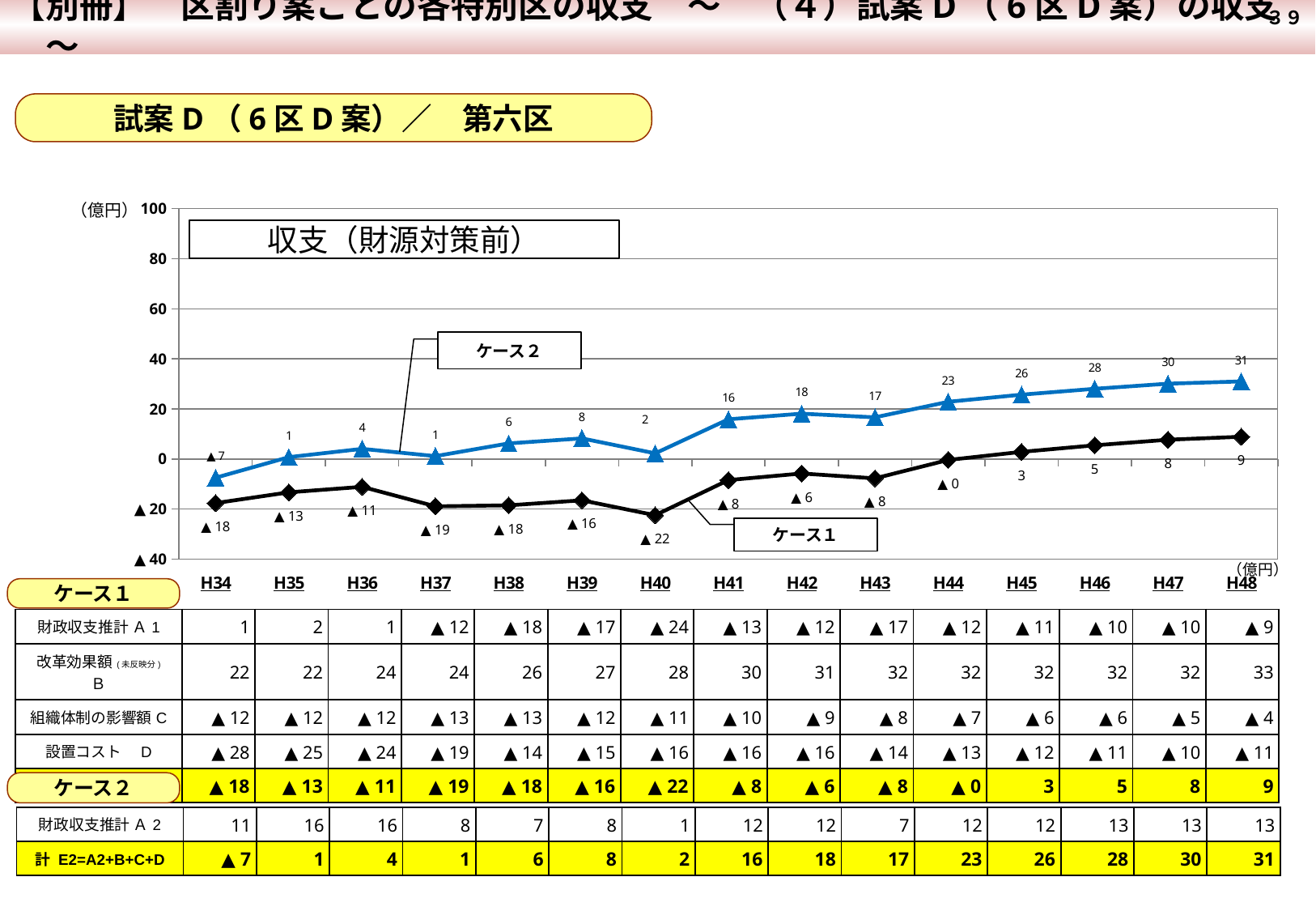
How many years (points) are plotted along the x axis of the chart? 15 How many series does the chart plot? 2 What is the value for ケース1 at H40? ▲22 In which year does ケース1 have its lowest value? H40 Does the ケース2 line generally rise or fall from H41 to H48? rise In which year does ケース2 reach its highest value? H48 What is the value for ケース2 at H48? 31 Which series has the larger value at H42, ケース1 or ケース2? ケース2 What is the value for ケース2 at H34? ▲7 What is the difference between ケース2 and ケース1 at H48? 22 What type of chart is shown on the slide? line chart What is the value for ケース1 at H45? 3